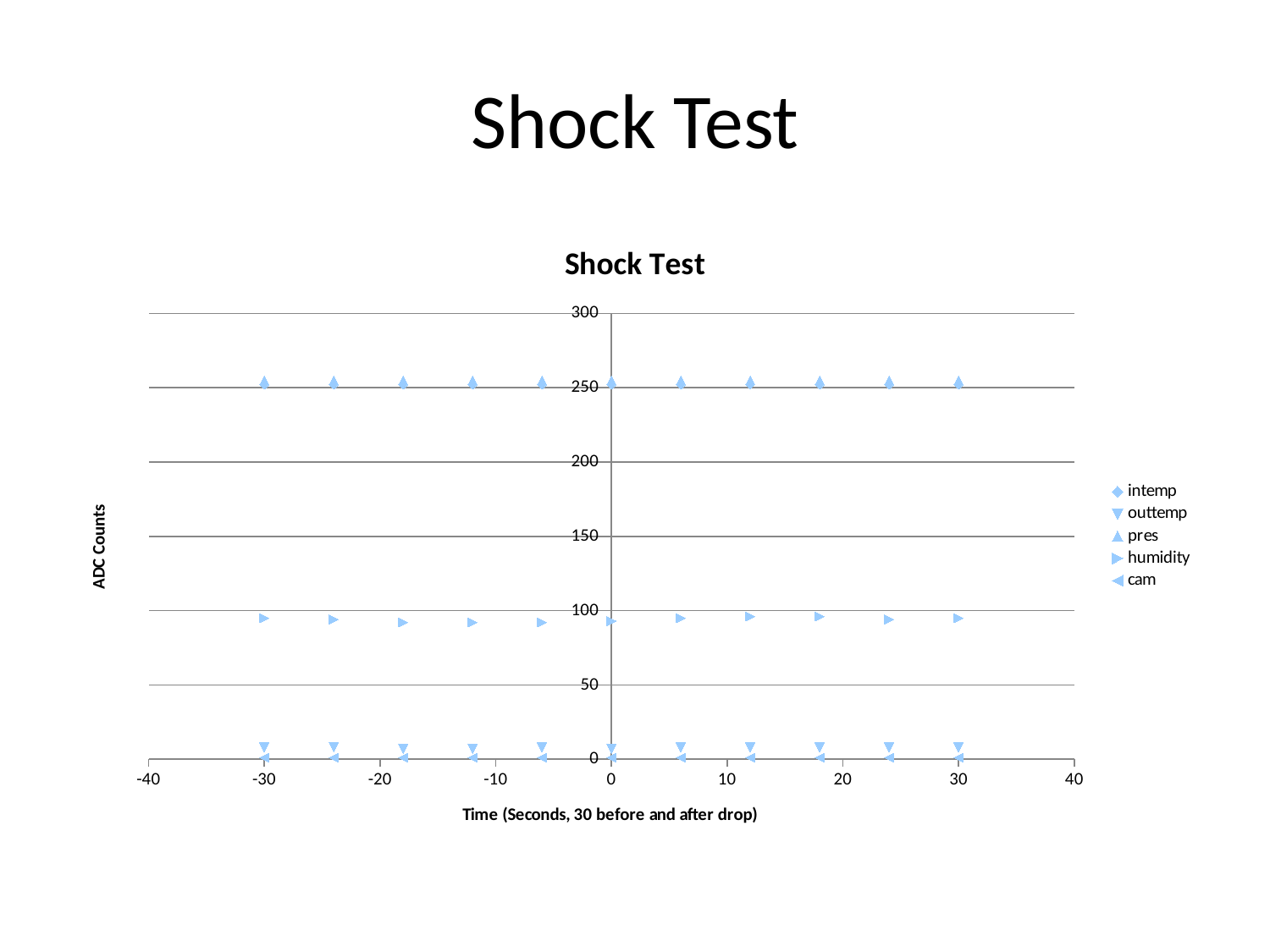
Is the value for humidity at time 30 greater or less than 50? greater Do the pres values rise, fall, or stay roughly flat across the time axis? stay roughly flat What kind of chart is shown on the slide? scatter chart Is the value for humidity at time 0 greater or less than 100? less What is the label of the vertical axis? ADC Counts How many series does the legend list? 5 Is the value for outtemp at time -30 greater or less than 50? less How many data points are plotted for the pres series? 11 Which series has the highest ADC Counts values? pres Which is larger at time -30: the value for humidity or the value for outtemp? humidity